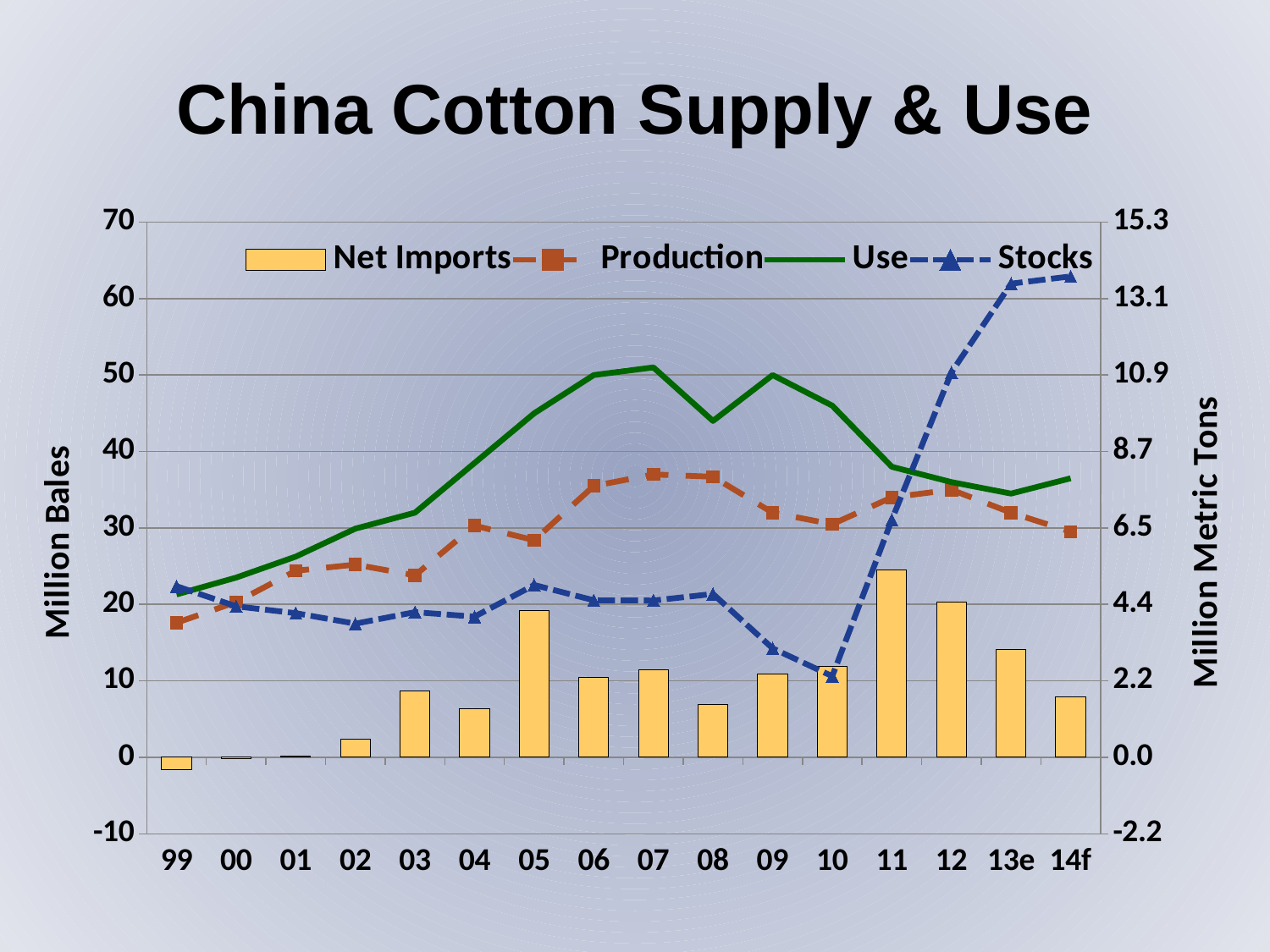
What is the title of the chart? China Cotton Supply & Use In which year is Use lowest? 99 In which year is Net Imports lowest? 99 Is the Net Imports value for 11 greater or less than 20 million bales? greater Is the Use value for 11 greater or less than 40 million bales? less Do Net Imports rise or fall from 11 to 14f? Fall What kind of chart is this? Combination bar and line chart Is the Production value for 99 greater or less than 20 million bales? less How many series does the legend list? 4 Which is larger in 07, Use or Production? Use How many years are shown on the x axis? 16 In which year is Net Imports highest? 11